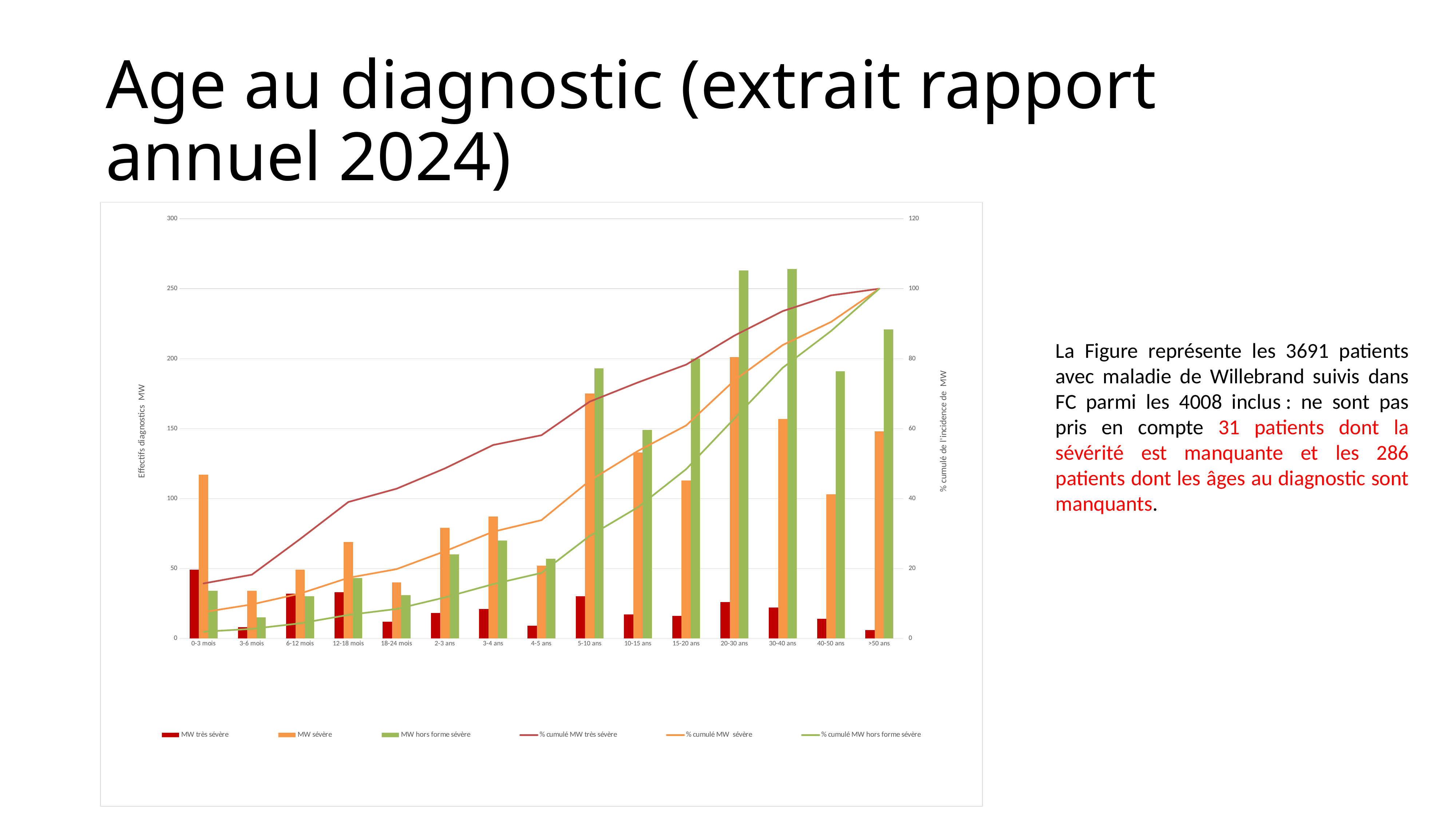
What colour represents MW très sévère in the legend? Red Is the MW hors forme sévère value for >50 ans greater or less than 200? greater Which age category has the lowest bar for MW hors forme sévère? 3-6 mois Is the MW très sévère value for 15-20 ans greater or less than 50? less What kind of chart is shown on the slide? Combined bar and line chart Which age category has the highest bar for MW sévère? 20-30 ans How many series does the chart's legend list? 6 Do the % cumulé lines rise or fall from 0-3 mois to >50 ans? rise Which age category has the highest bar for MW très sévère? 0-3 mois Is the MW sévère value for 0-3 mois greater or less than 100? greater For 0-3 mois, which bar is larger: MW sévère or MW hors forme sévère? MW sévère How many age categories are shown on the x axis of the chart? 15